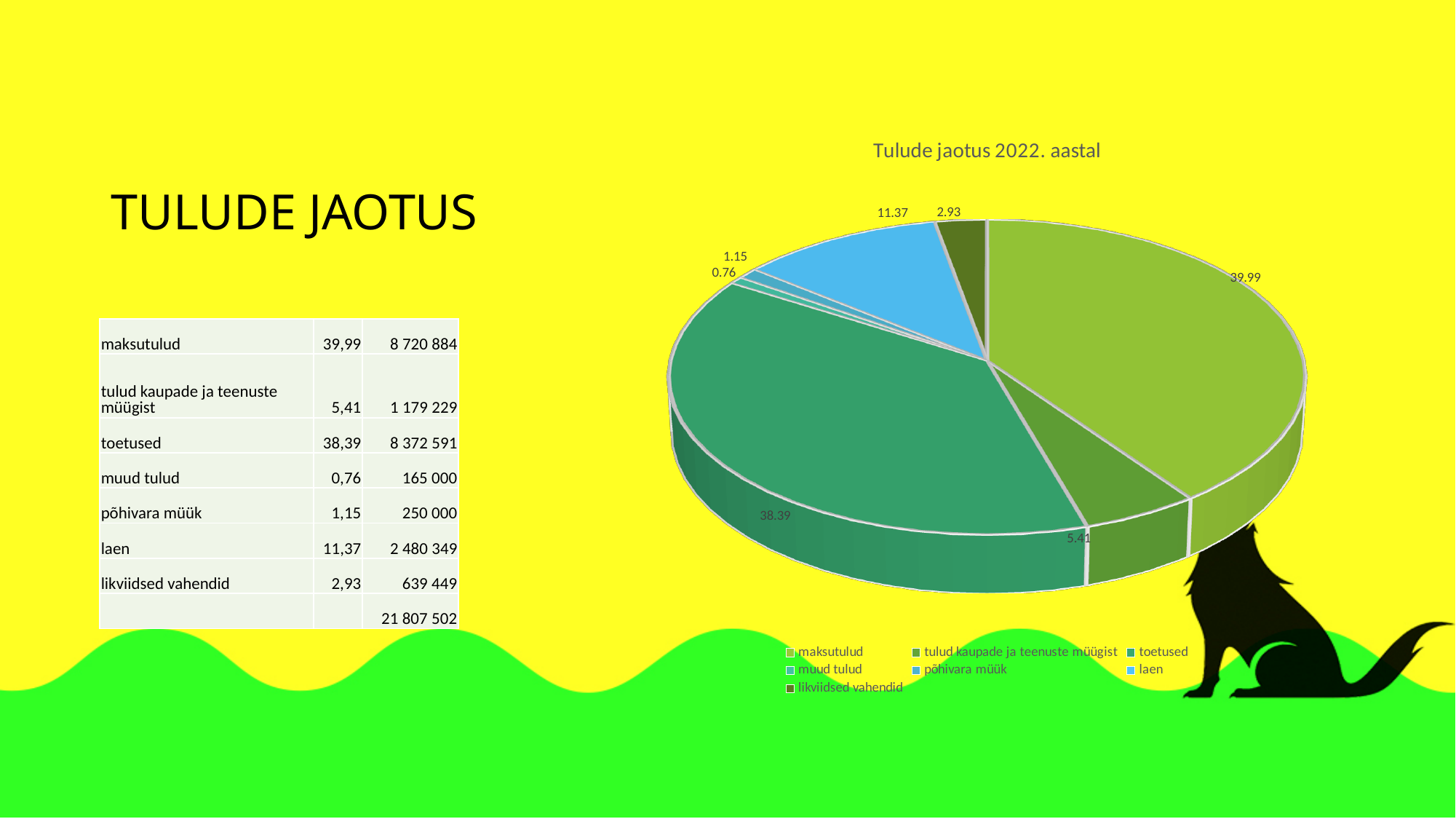
What is the difference between the laen value and the likviidsed vahendid value? 8.44 What kind of chart is shown on the slide? Pie chart What value is shown for the toetused slice? 38.39 What is the title of the chart? Tulude jaotus 2022. aastal Which category has the smallest slice in the pie chart? muud tulud What value is shown for the tulud kaupade ja teenuste müügist slice? 5.41 How many slices does the pie chart have? 7 What value is shown for the likviidsed vahendid slice? 2.93 What value is shown for the laen slice? 11.37 What value is shown for the maksutulud slice? 39.99 Which is larger, the laen slice or the põhivara müük slice? laen